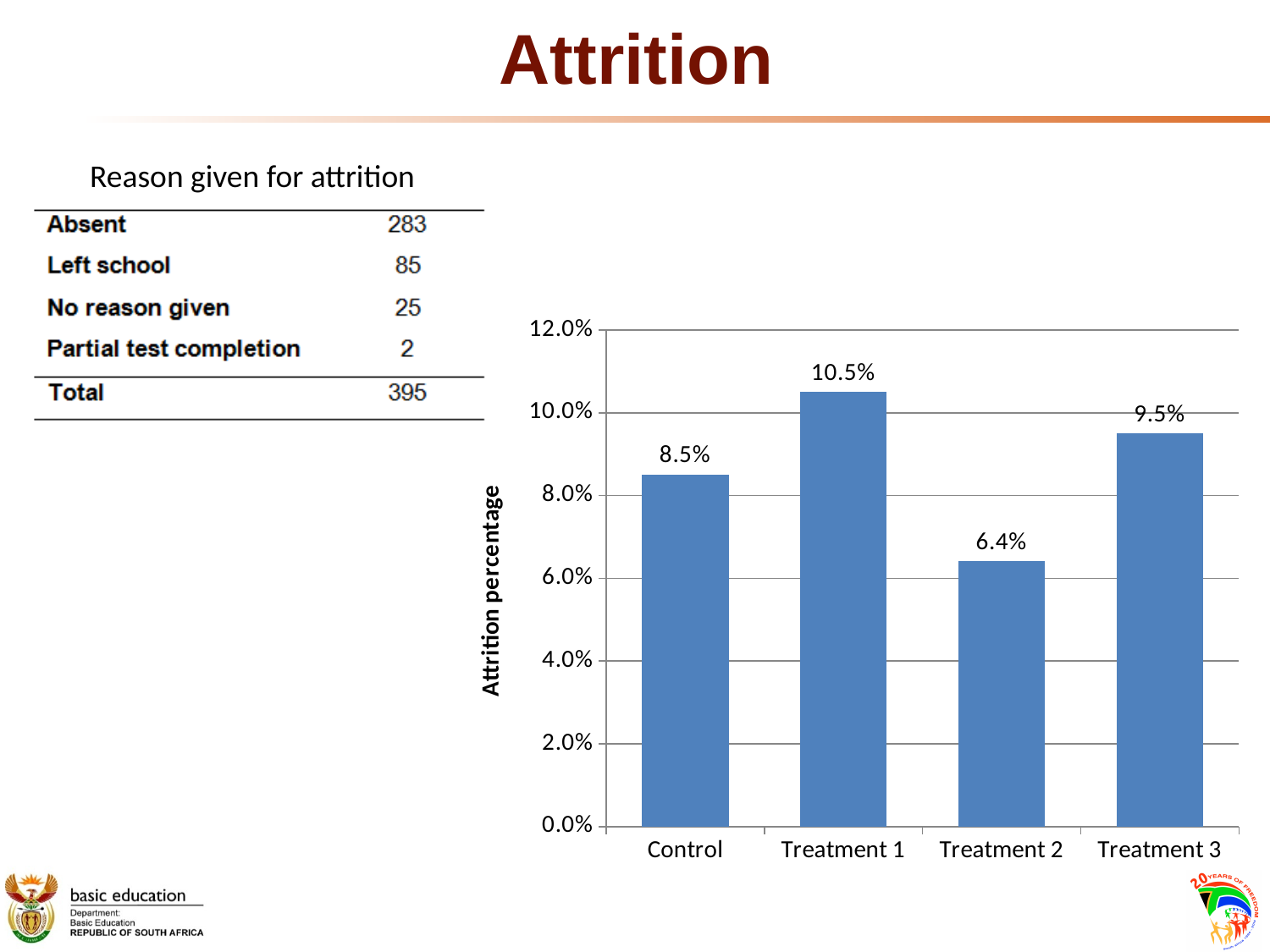
What kind of chart is used to show attrition percentage? bar chart What is the difference in attrition percentage between Treatment 1 and Treatment 2? 4.1% Which group has the highest attrition percentage? Treatment 1 What is the attrition percentage for Treatment 3? 9.5% What is the attrition percentage for Treatment 1? 10.5% Which group has the lowest attrition percentage? Treatment 2 How many groups are shown on the x axis of the chart? 4 Which has a higher attrition percentage, Control or Treatment 3? Treatment 3 Is the attrition percentage for Treatment 1 greater or less than 10.0%? greater What is the label on the vertical axis of the chart? Attrition percentage What is the attrition percentage for the Control group? 8.5% What is the attrition percentage for Treatment 2? 6.4%